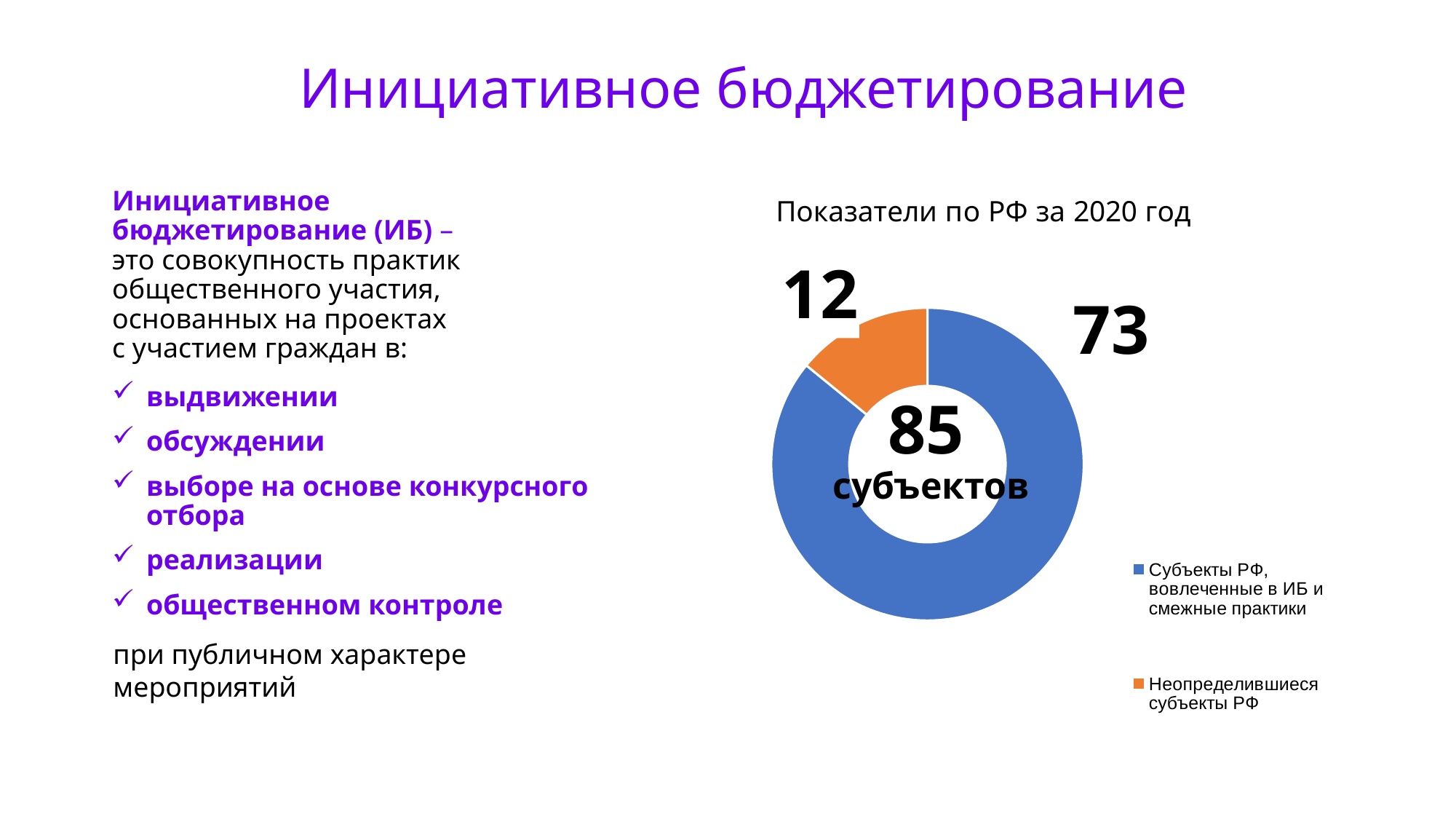
Which is larger: the value for "Субъекты РФ, вовлеченные в ИБ и смежные практики" or for "Неопределившиеся субъекты РФ"? Субъекты РФ, вовлеченные в ИБ и смежные практики How many entries does the chart legend list? 2 What colour is the slice for "Неопределившиеся субъекты РФ"? Orange What is the total number of subjects shown in the centre of the chart? 85 субъектов What is the difference between the values for "Субъекты РФ, вовлеченные в ИБ и смежные практики" and "Неопределившиеся субъекты РФ"? 61 How many categories are shown in the chart? 2 What is the value for "Неопределившиеся субъекты РФ" in the chart? 12 What kind of chart is shown on the slide? Doughnut (pie) chart What is the value for "Субъекты РФ, вовлеченные в ИБ и смежные практики" in the chart? 73 What is the title of the chart? Показатели по РФ за 2020 год Which category has the smallest slice in the chart? Неопределившиеся субъекты РФ Which category has the largest slice in the chart? Субъекты РФ, вовлеченные в ИБ и смежные практики